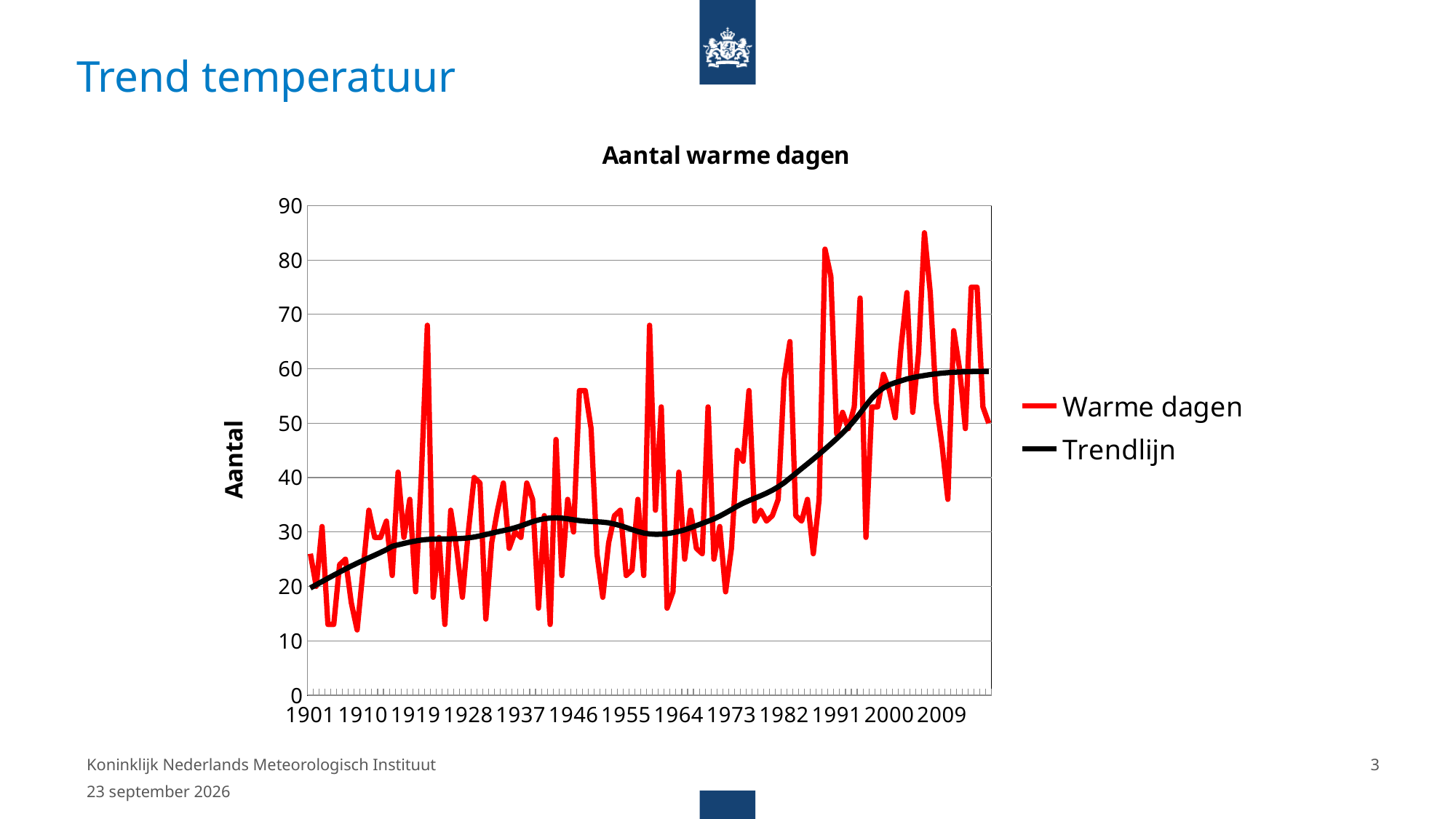
What is the title of the chart? Aantal warme dagen How many series does the legend of the chart list? 2 What is the highest tick value shown on the vertical axis? 90 Is the value of the Trendlijn at 1901 greater or less than 30? less Is the highest value reached by the Warme dagen series greater or less than 80? greater What kind of chart is shown on the slide? line chart Is the value of the Trendlijn at 2009 greater or less than 50? greater Does the Trendlijn series rise or fall overall from 1901 to 2009? rise Which is larger: the Trendlijn value at 1901 or the Trendlijn value at 2009? 2009 What are the two series named in the legend? Warme dagen and Trendlijn